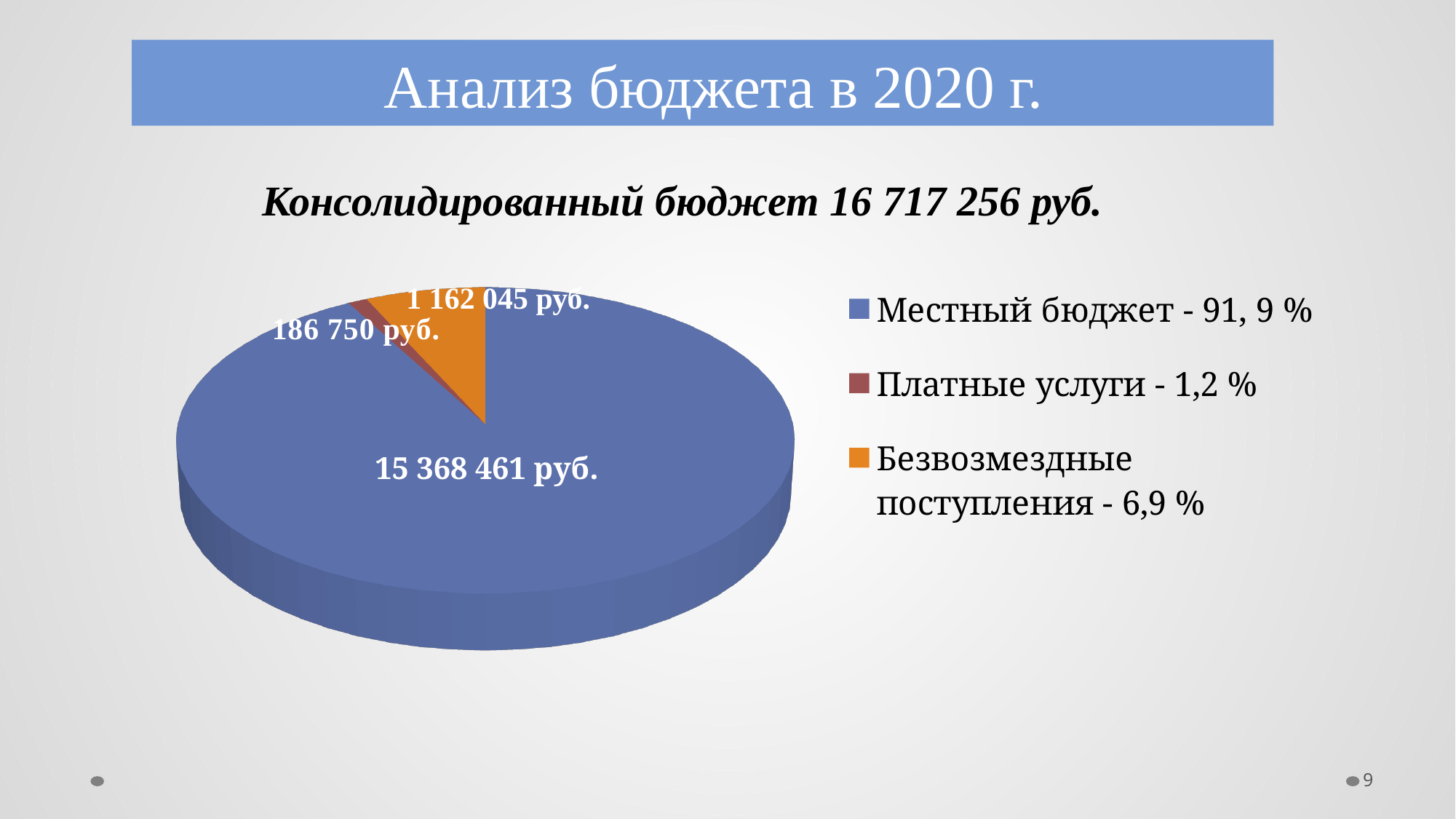
What colour is the slice for Безвозмездные поступления? orange What share of the pie does Безвозмездные поступления represent? 6,9 % What is the value for Платные услуги? 186 750 руб. What is the value for Безвозмездные поступления? 1 162 045 руб. What share of the pie does Платные услуги represent? 1,2 % Which category has the smallest slice of the pie? Платные услуги What type of chart is shown on the slide? pie chart What is the value for Местный бюджет? 15 368 461 руб. What is the difference between the values for Местный бюджет and Безвозмездные поступления? 14 206 416 руб. Which category has the largest slice of the pie? Местный бюджет How many categories does the pie chart have? 3 Which is larger, the value for Безвозмездные поступления or the value for Платные услуги? Безвозмездные поступления